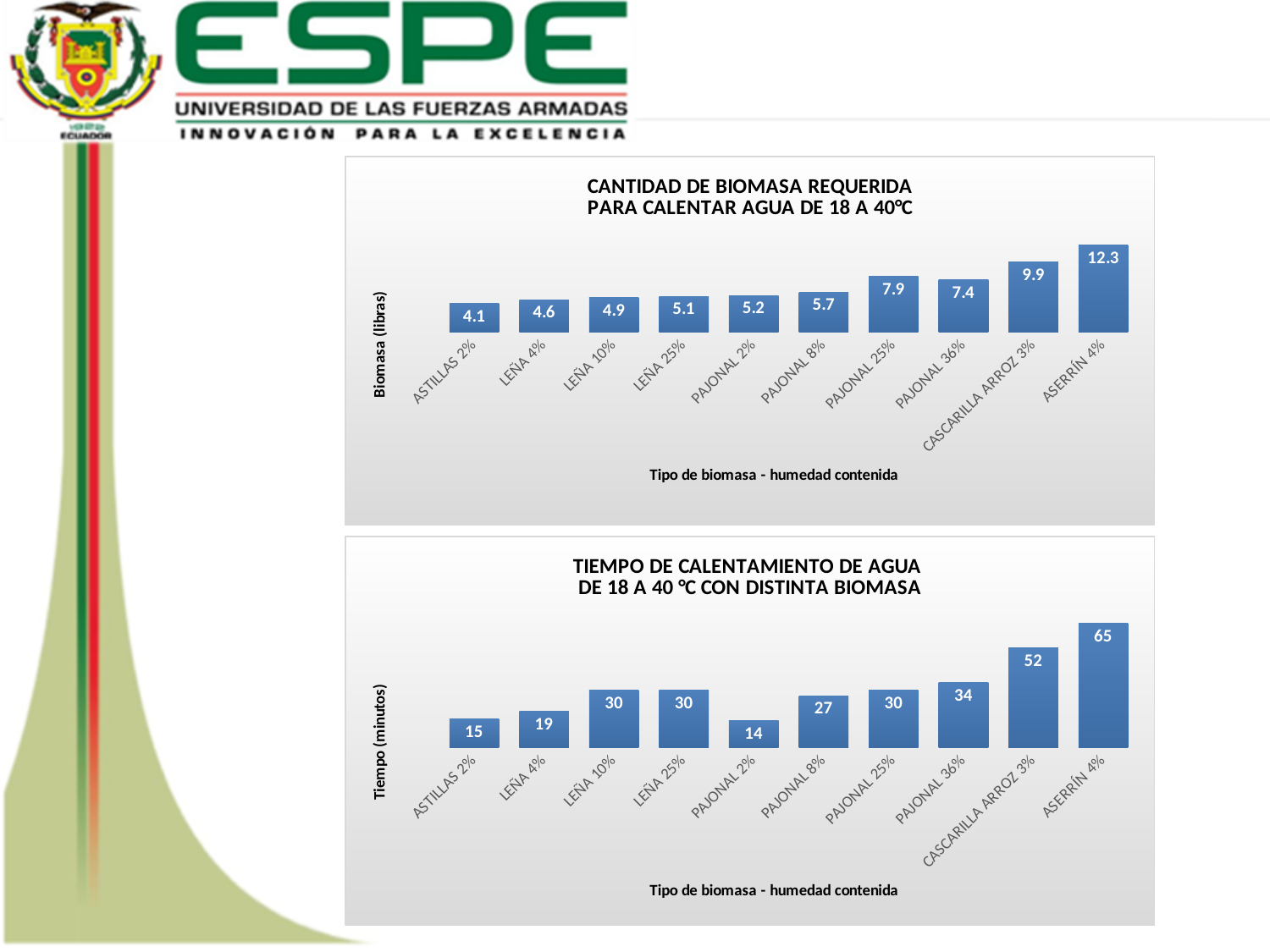
In the top chart (CANTIDAD DE BIOMASA REQUERIDA), which category has the highest value? ASERRÍN 4% In the bottom chart (TIEMPO DE CALENTAMIENTO DE AGUA), which category has the highest value? ASERRÍN 4% In the top chart (CANTIDAD DE BIOMASA REQUERIDA), what is the difference between the values for CASCARILLA ARROZ 3% and PAJONAL 36%? 2.5 What kind of chart is the bottom chart (TIEMPO DE CALENTAMIENTO DE AGUA)? bar chart In the bottom chart (TIEMPO DE CALENTAMIENTO DE AGUA), what is the difference between the values for ASERRÍN 4% and CASCARILLA ARROZ 3%? 13 How many categories are shown in the top chart (CANTIDAD DE BIOMASA REQUERIDA)? 10 In the bottom chart (TIEMPO DE CALENTAMIENTO DE AGUA), which is larger, PAJONAL 8% or PAJONAL 36%? PAJONAL 36% What is the x-axis title of the bottom chart (TIEMPO DE CALENTAMIENTO DE AGUA)? Tipo de biomasa - humedad contenida In the top chart (CANTIDAD DE BIOMASA REQUERIDA), which is larger, PAJONAL 25% or PAJONAL 36%? PAJONAL 25% In the top chart (CANTIDAD DE BIOMASA REQUERIDA), which category has the lowest value? ASTILLAS 2% In the bottom chart (TIEMPO DE CALENTAMIENTO DE AGUA), what is the value for PAJONAL 2%? 14 In the top chart (CANTIDAD DE BIOMASA REQUERIDA), what is the value for LEÑA 10%? 4.9